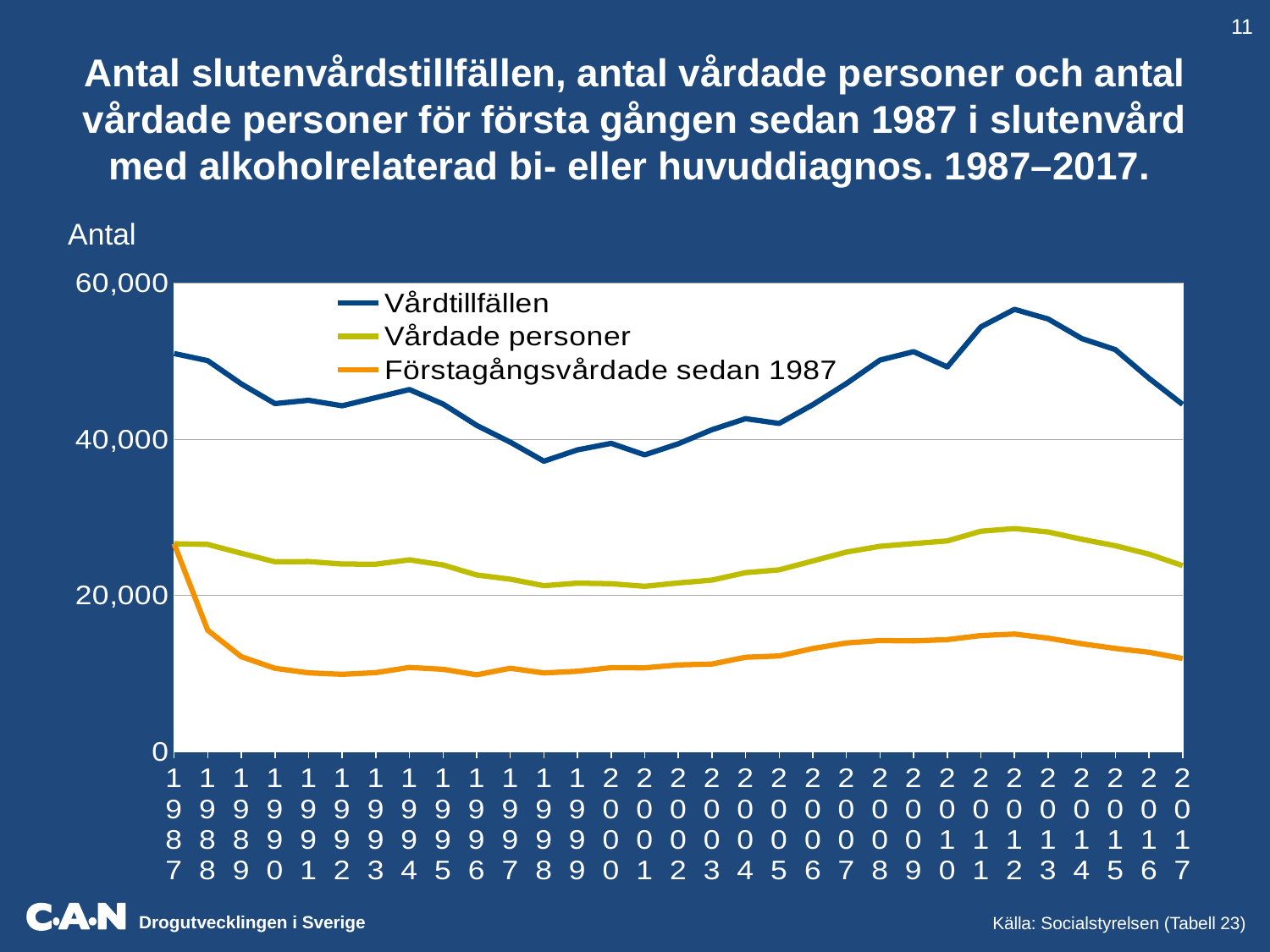
Is the value for Vårdtillfällen in 1998 greater or less than 40,000? less In which year does the Vårdtillfällen series reach its highest value? 2012 How many years are plotted along the x axis? 31 Is the value for Vårdtillfällen in 2012 greater or less than 40,000? greater Is the value for Vårdade personer in 2012 greater or less than 20,000? greater Does the Vårdtillfällen series rise or fall from 2012 to 2017? Fall Which is larger in 2017: Vårdtillfällen or Vårdade personer? Vårdtillfällen What is the label on the y axis? Antal How many series does the legend list? 3 Which series has the highest values across the whole period? Vårdtillfällen What kind of chart is shown on the slide? Line chart